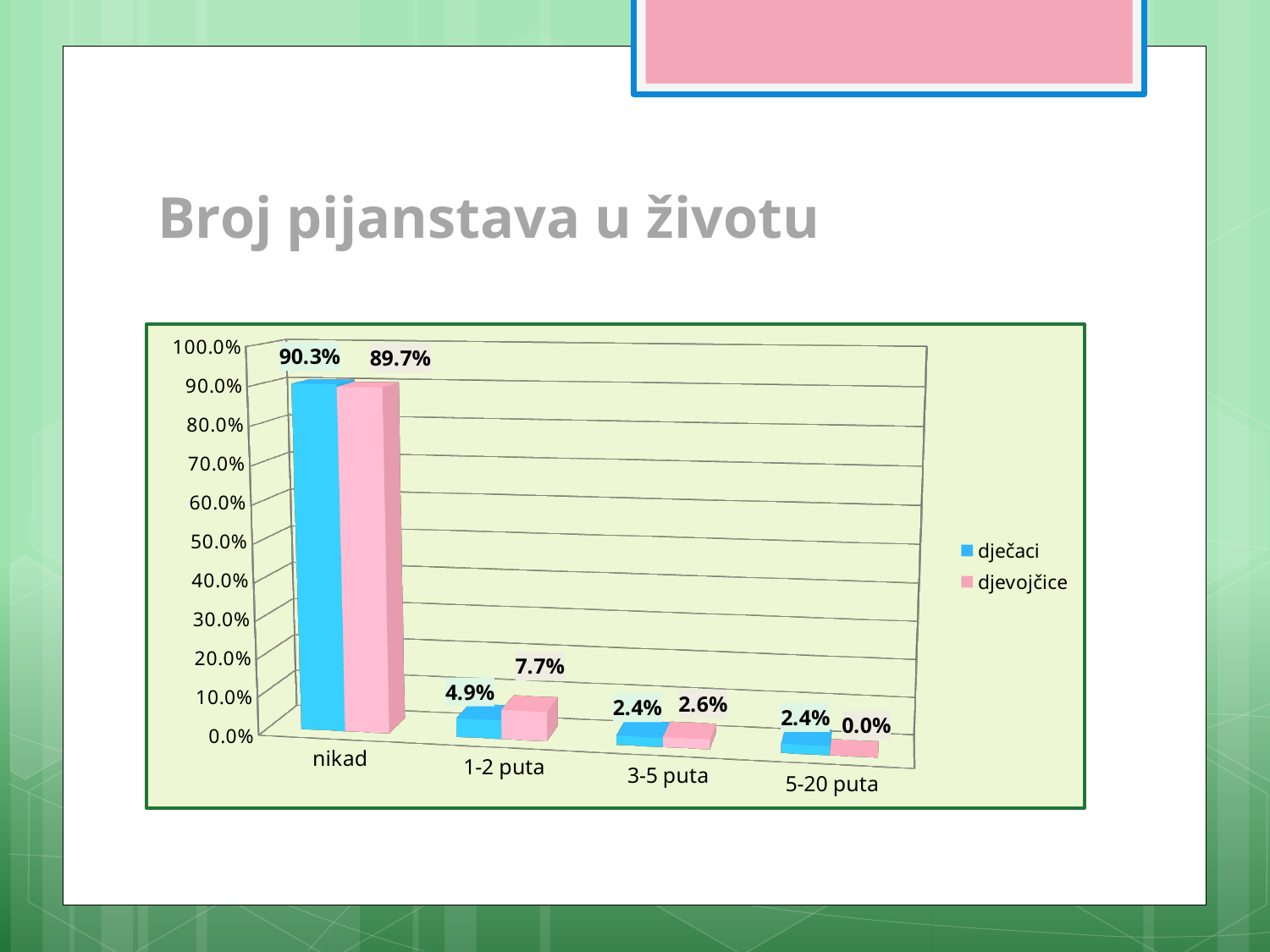
What is the difference between dječaci and djevojčice in the nikad category? 0.6% What is the value for djevojčice in the 1-2 puta category? 7.7% What kind of chart is shown on the slide? bar chart Which category has the highest value for djevojčice? nikad What is the value for dječaci in the 3-5 puta category? 2.4% How many categories are shown on the x axis? 4 In the 1-2 puta category, which series has the larger value, dječaci or djevojčice? djevojčice How many series does the legend list? 2 What is the value for dječaci in the nikad category? 90.3% Which category has the lowest value for djevojčice? 5-20 puta What is the difference between dječaci and djevojčice in the 1-2 puta category? 2.8% What is the value for djevojčice in the 5-20 puta category? 0.0%